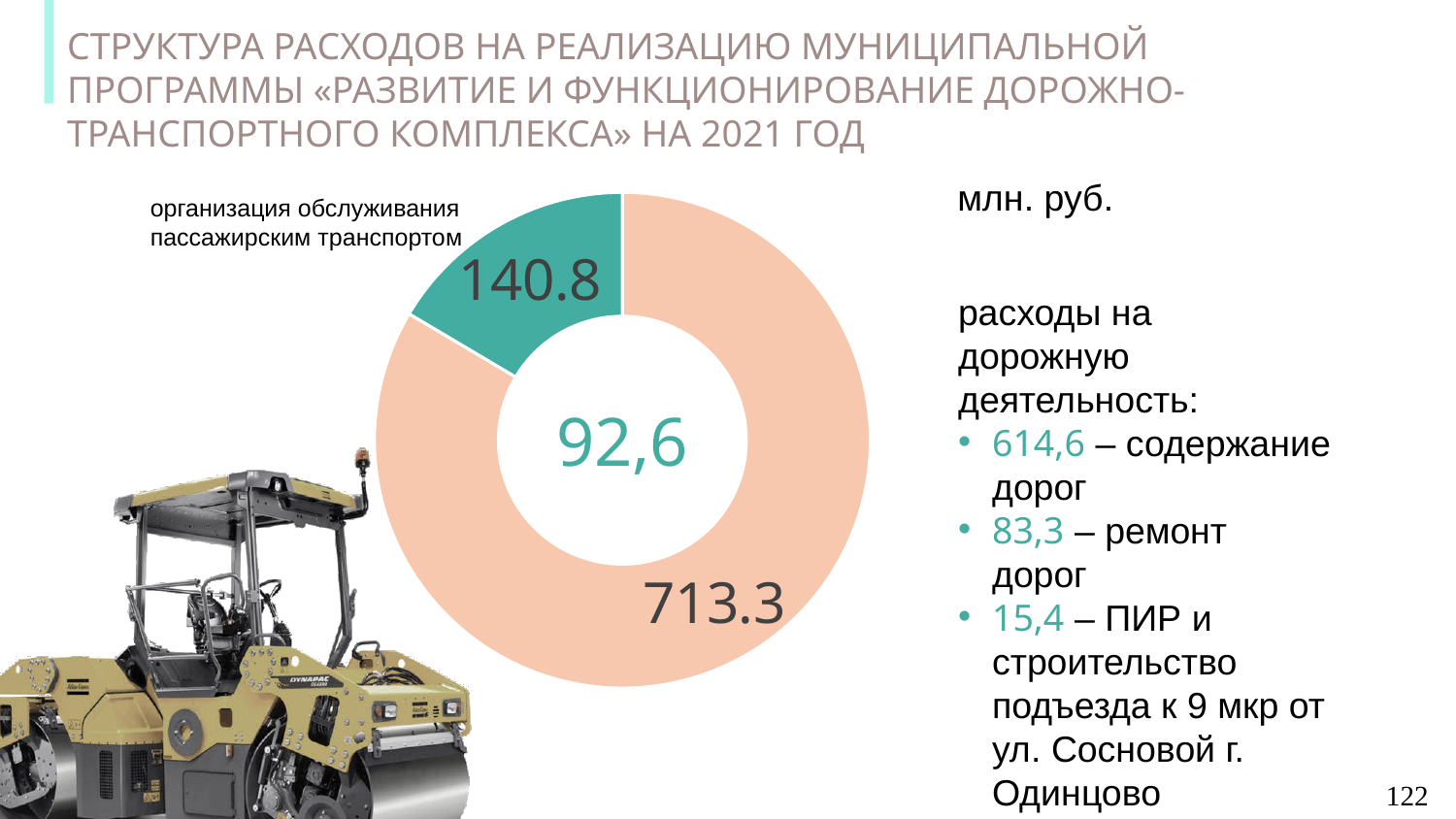
How many slices does the chart have? 2 In what units are the chart values given, according to the slide? млн. руб. What value is printed on the large peach-coloured slice of the chart? 713.3 What is the total of the two slice values shown on the chart? 854.1 What kind of chart is shown on the slide? pie (donut) chart What value is shown for the slice labelled «организация обслуживания пассажирским транспортом»? 140.8 What is the difference between the two slice values, 713.3 and 140.8? 572.5 Which is larger: the slice for «организация обслуживания пассажирским транспортом» or the peach slice? the peach slice (713.3) Which slice of the chart is the smallest? организация обслуживания пассажирским транспортом (140.8) What number is printed in the centre of the donut chart? 92,6 Which slice of the chart is the largest? the peach slice, 713.3